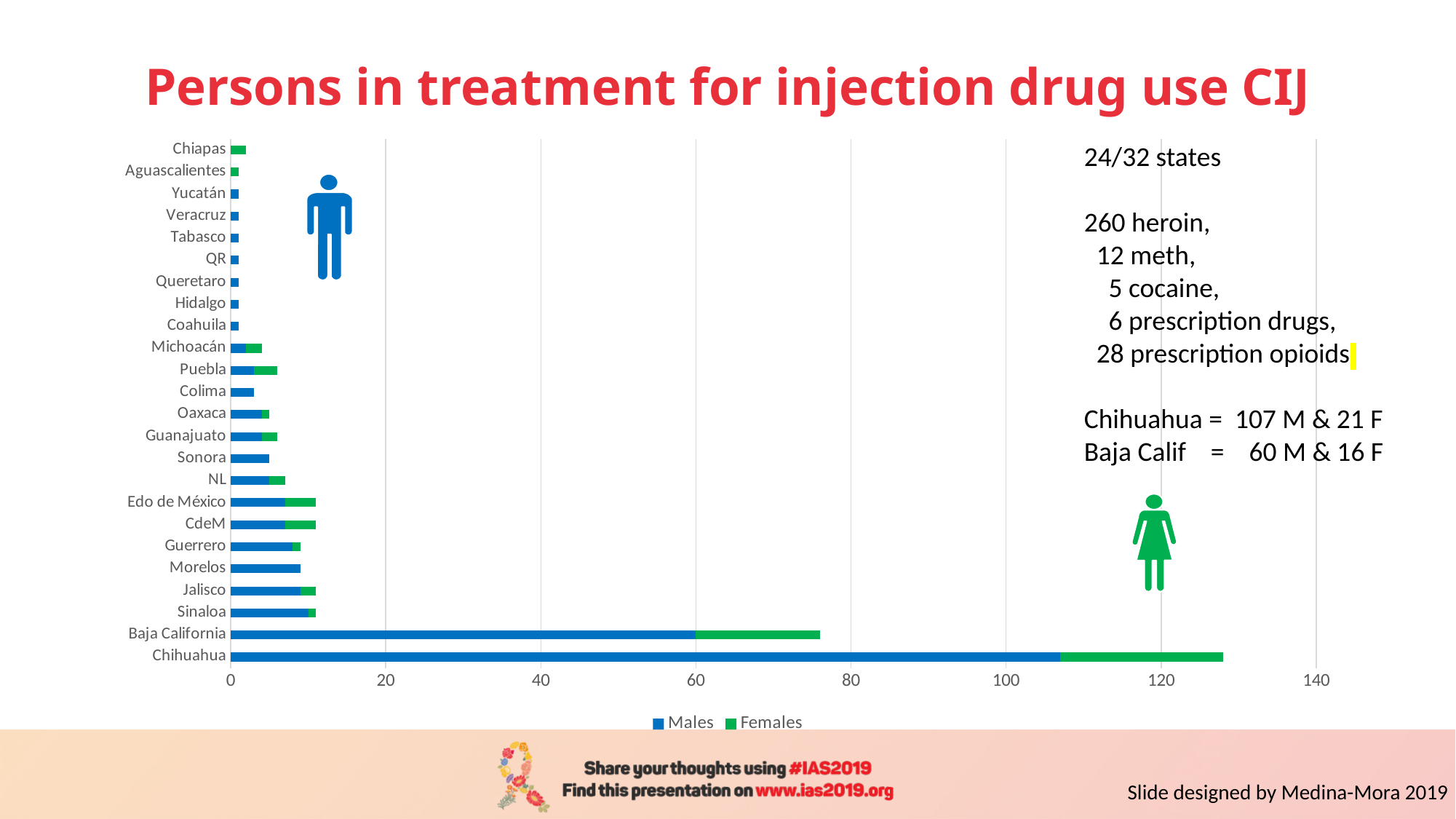
What is the total (males plus females) of the stacked bar for Baja California? 76 Which state has the longest bar on the chart? Chihuahua How many series does the chart legend list? 2 How many states (categories) are plotted on the chart? 24 Which has a longer bar, Baja California or Sinaloa? Baja California What is the total (males plus females) of the stacked bar for Chihuahua? 128 What is the difference between the number of males for Chihuahua and the number of males for Baja California? 47 Is the total bar length for Sinaloa greater or less than 20? less What kind of chart is shown on the slide? bar chart What is the number of females in treatment for Baja California? 16 What are the two entries in the chart legend? Males and Females What is the number of males in treatment for Chihuahua? 107